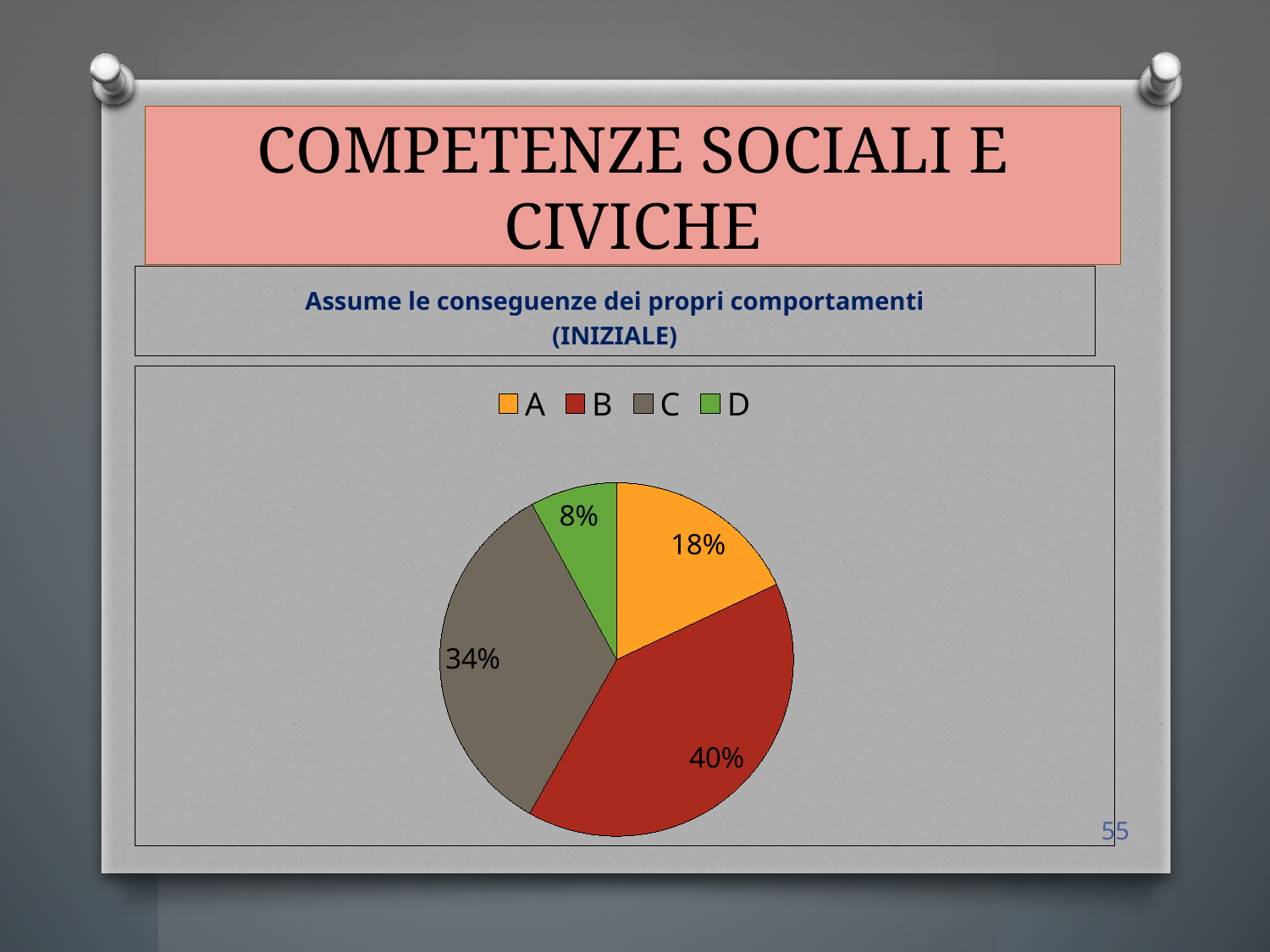
What is the difference in percentage points between category B and category C? 6 What is the share for category D? 8% Which category has the smallest slice of the pie? D What is the share for category C? 34% How many slices does the pie chart have? 4 What colour is the slice for category D? green What is the share for category A? 18% How many categories does the legend list? 4 Which is larger, the share for A or the share for C? C What kind of chart is shown on the slide? pie chart Which category has the largest slice of the pie? B What is the share for category B? 40%